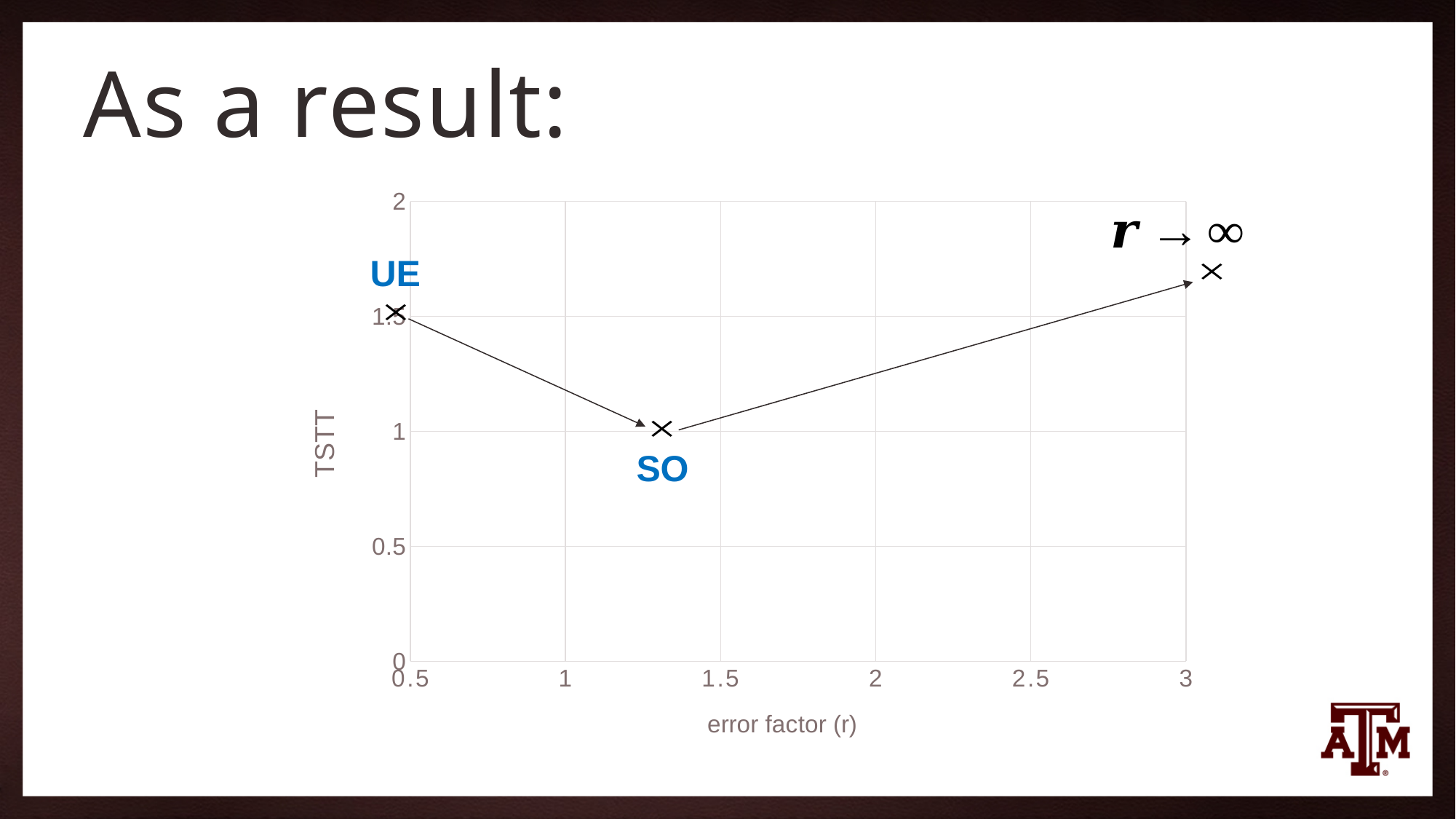
What is the TSTT value for the point labelled SO? 1 What is the TSTT value for the point labelled UE? 1.5 Is the TSTT value for the r → ∞ point greater or less than 1.5? greater Which labelled point has the lowest TSTT? SO What is the label of the x axis? error factor (r) Is the TSTT value for the r → ∞ point greater or less than 2? less Which has a larger TSTT, UE or SO? UE Does TSTT rise or fall from the SO point to the r → ∞ point? rise Which point has the highest TSTT? the r → ∞ point What is the difference in TSTT between UE and SO? 0.5 What kind of chart is shown on the slide? scatter chart How many data points are plotted on the chart? 3